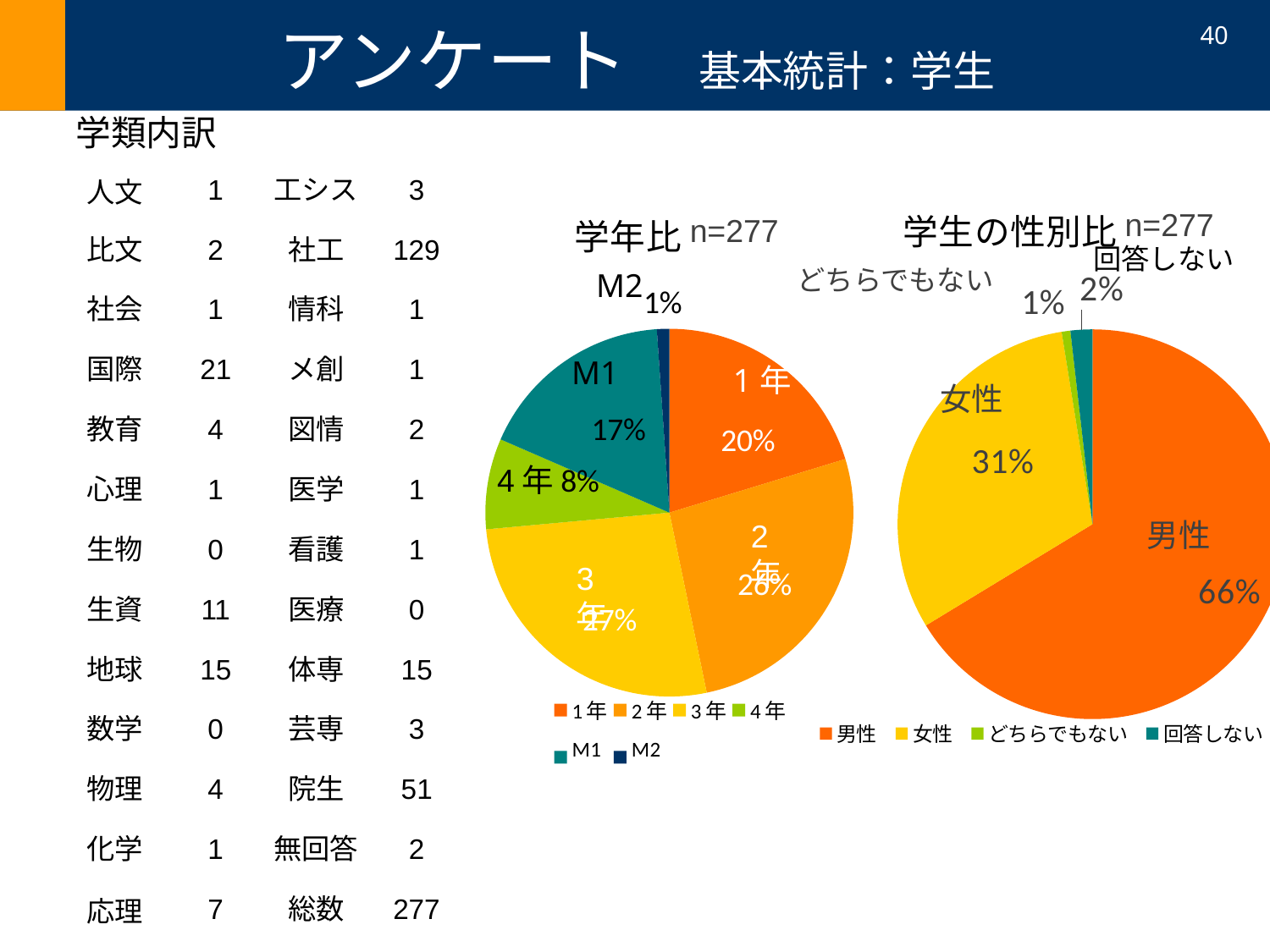
In the 学生の性別比 chart, what share is 男性? 66% In the 学年比 chart, what share is 4年? 8% In the 学生の性別比 chart, what is the difference between 男性 and 女性? 35% In the 学年比 chart, which category has the smallest share? M2 In the 学年比 chart, what share is M1? 17% What is the n value shown next to the 学年比 chart title? n=277 In the 学生の性別比 chart, which category has the largest share? 男性 In the 学年比 chart, what share is 1年? 20% In the 学年比 chart, how many categories does the legend list? 6 What kind of chart is the 学生の性別比 chart? pie chart In the 学生の性別比 chart, what share is 女性? 31% In the 学年比 chart, which is larger, 1年 or 4年? 1年